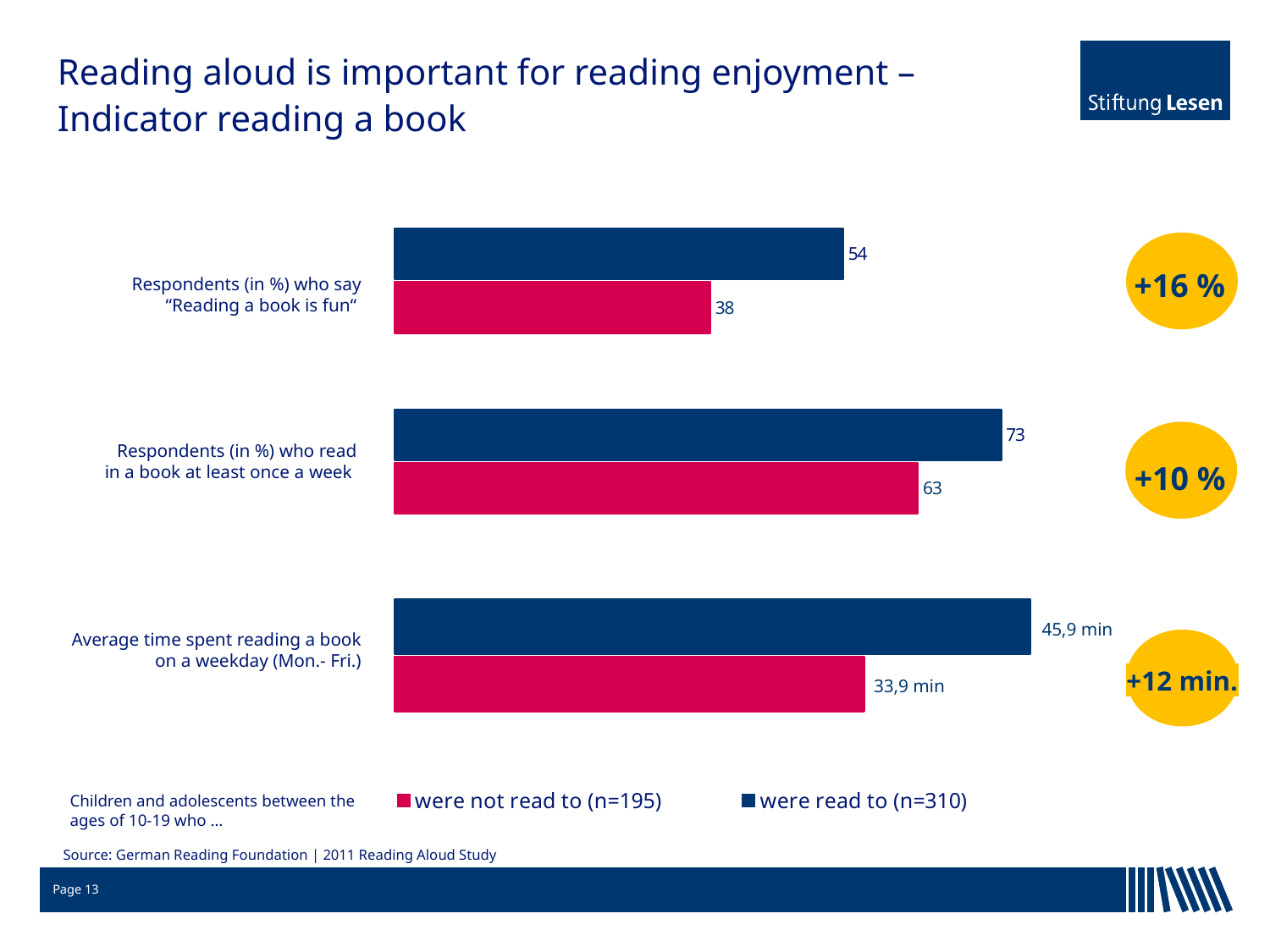
What is the average time spent reading a book on a weekday for those who were not read to? 33,9 min What is the difference between the "were read to" and "were not read to" values for respondents who say "Reading a book is fun"? 16 Which group has the larger value for reading in a book at least once a week: were read to or were not read to? were read to What percentage of respondents who were not read to read in a book at least once a week? 63 What percentage of respondents who were not read to say "Reading a book is fun"? 38 How many categories are shown in the chart? 3 What is the average time spent reading a book on a weekday for those who were read to? 45,9 min What kind of chart is shown on the slide? bar chart What percentage of respondents who were read to say "Reading a book is fun"? 54 Which colour represents the "were not read to (n=195)" series? red What is the difference between the "were read to" and "were not read to" values for respondents who read in a book at least once a week? 10 How many series does the legend list? 2